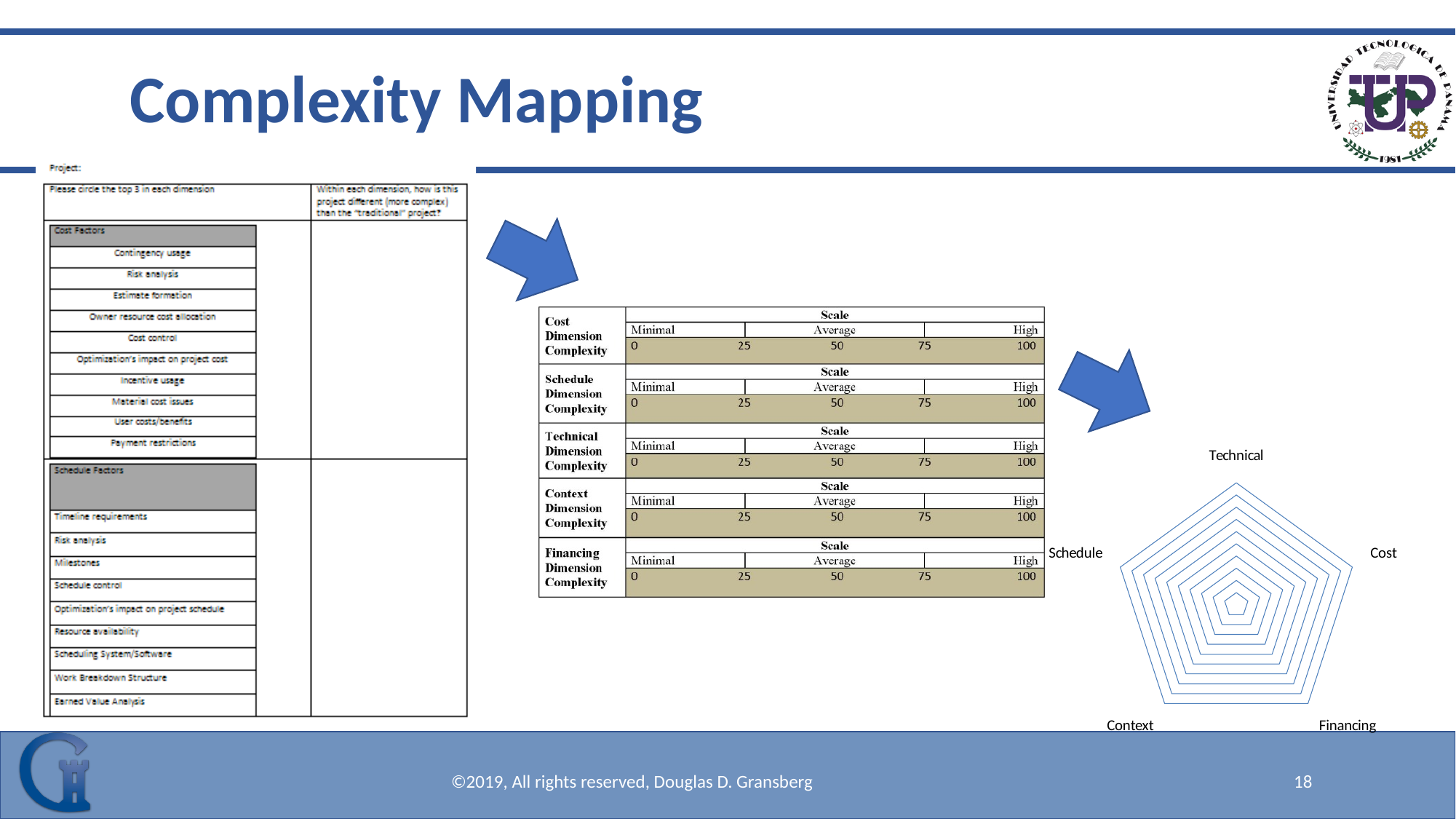
What kind of chart is shown on the right side of the slide? radar chart Which category label is on the left side of the radar chart? Schedule Which category label is on the right side of the radar chart? Cost Which two category labels appear at the bottom of the radar chart? Context and Financing How many axes (categories) does the radar chart on the right have? 5 Which category label appears at the top of the radar chart? Technical